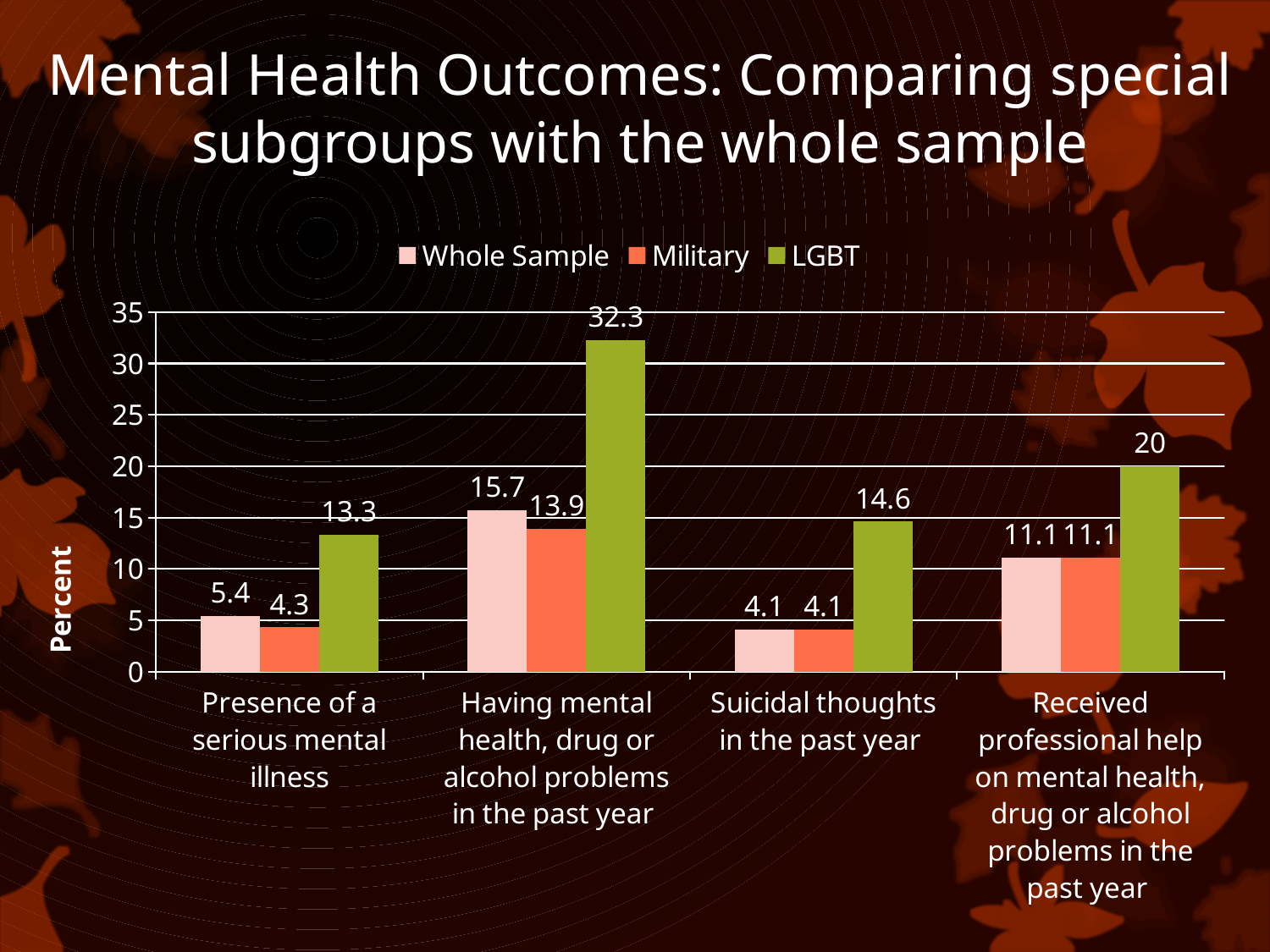
How many categories are shown on the x axis? 4 How many series does the legend list? 3 Which category has the lowest Military value? Suicidal thoughts in the past year What is the LGBT value for 'Having mental health, drug or alcohol problems in the past year'? 32.3 What is the LGBT value for 'Received professional help on mental health, drug or alcohol problems in the past year'? 20 What is the Military value for 'Suicidal thoughts in the past year'? 4.1 For 'Having mental health, drug or alcohol problems in the past year', which is larger: the Whole Sample value or the Military value? Whole Sample What kind of chart is shown on the slide? Bar chart What is the Whole Sample value for 'Presence of a serious mental illness'? 5.4 What is the label of the vertical axis? Percent Which category has the highest LGBT value? Having mental health, drug or alcohol problems in the past year What is the difference between the LGBT and Whole Sample values for 'Presence of a serious mental illness'? 7.9